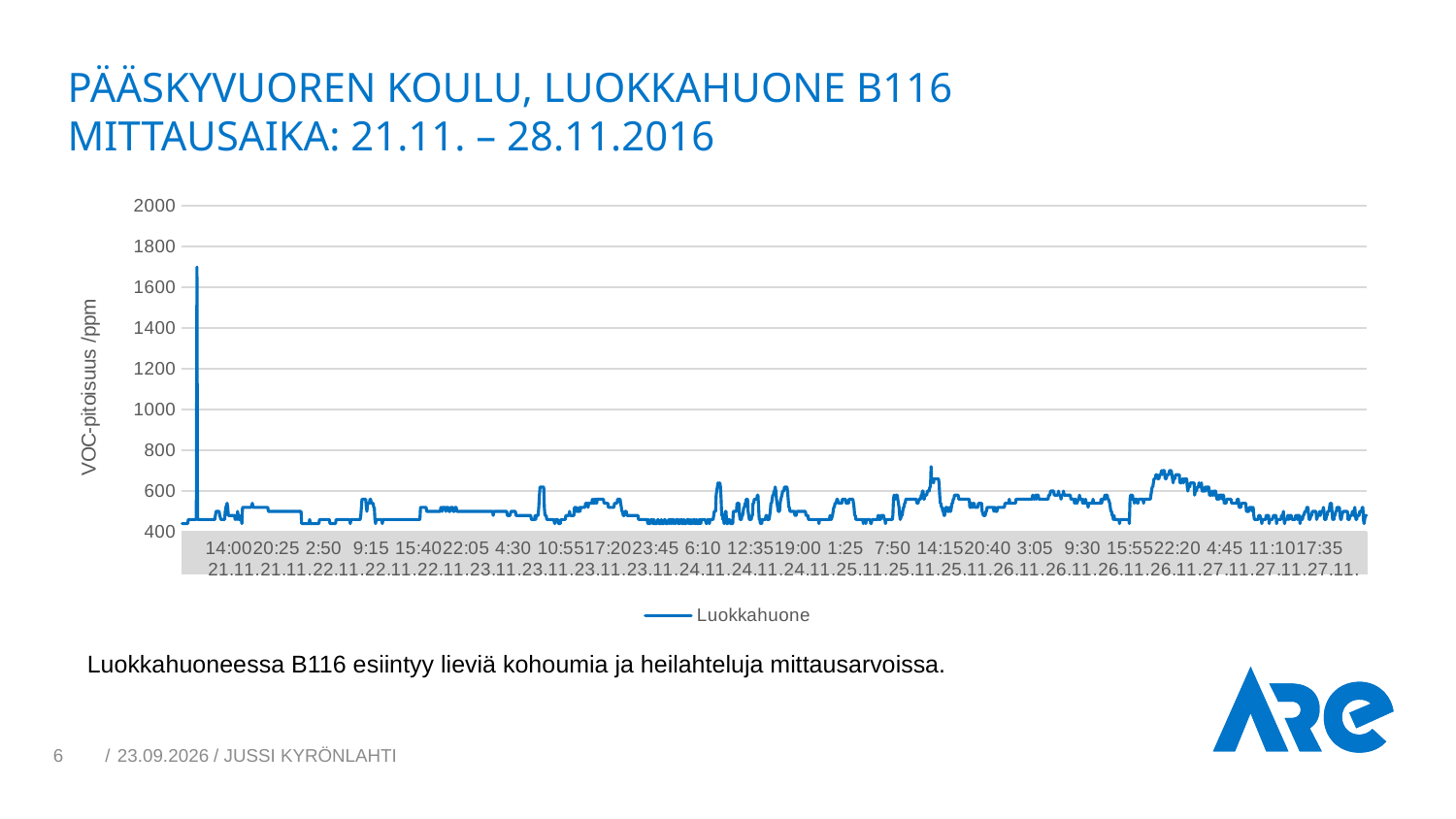
Is the value for Luokkahuone at 9:30 26.11. greater or less than 1000? less How many series does the legend list? 1 Is the highest peak of the Luokkahuone line, near the start of the measurement period, greater or less than 1600? greater Is the value for Luokkahuone at 2:50 22.11. greater or less than 800? less What is the label of the vertical axis? VOC-pitoisuus /ppm What kind of chart is shown on the slide? line chart What is the highest value shown on the vertical axis? 2000 What is the name of the series shown in the legend? Luokkahuone